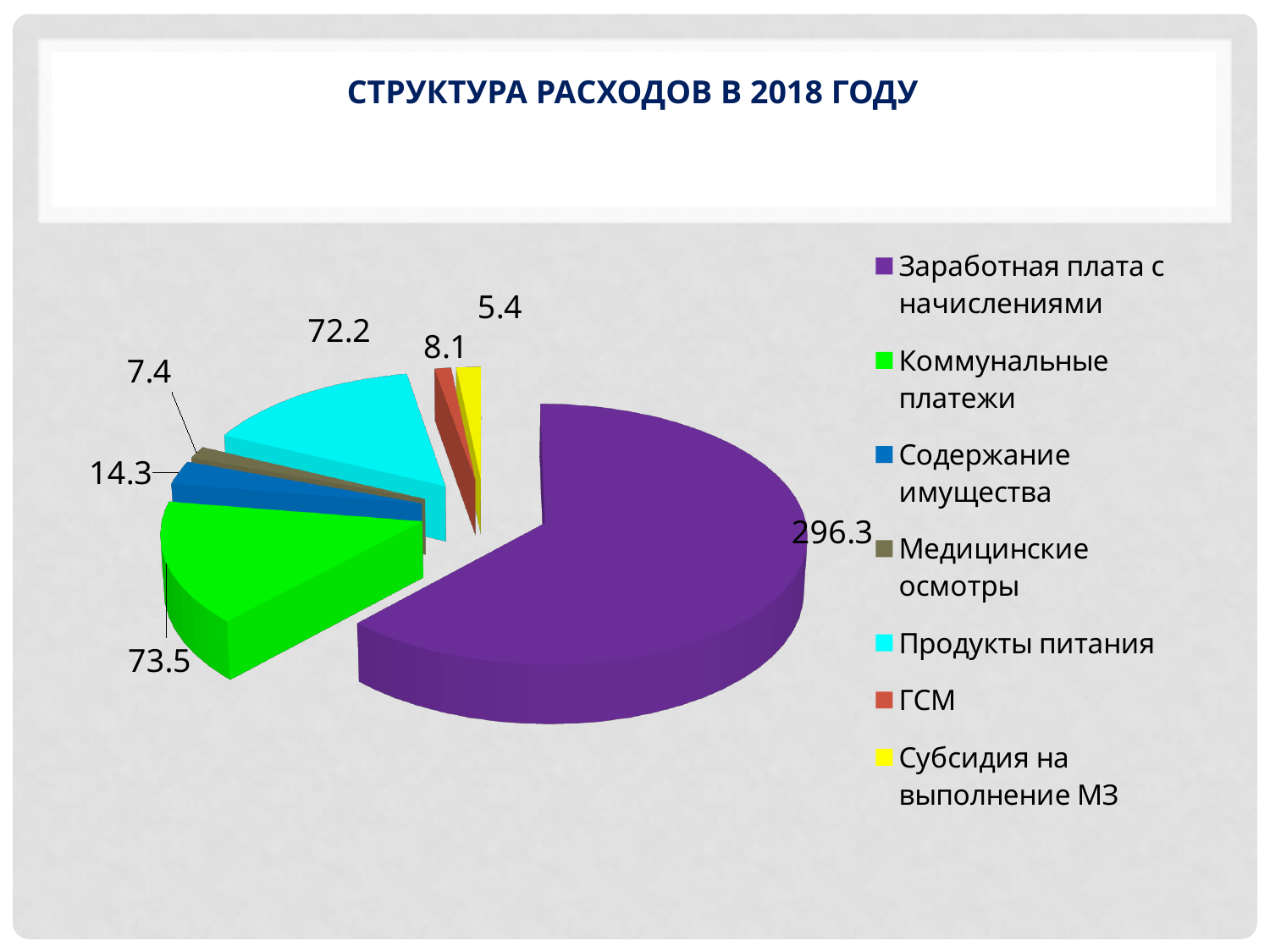
What type of chart is shown on the slide? Pie chart What colour is the slice for Продукты питания? Cyan What is the difference between the values for Коммунальные платежи and Продукты питания? 1.3 What is the value for Содержание имущества? 14.3 What is the value for Заработная плата с начислениями? 296.3 What is the value for Коммунальные платежи? 73.5 What is the title of the chart? СТРУКТУРА РАСХОДОВ В 2018 ГОДУ Which category has the largest slice of the pie? Заработная плата с начислениями Which is larger, the value for ГСМ or the value for Медицинские осмотры? Медицинские осмотры What is the value for Продукты питания? 72.2 Which category has the smallest slice of the pie? ГСМ How many slices does the pie chart have? 7